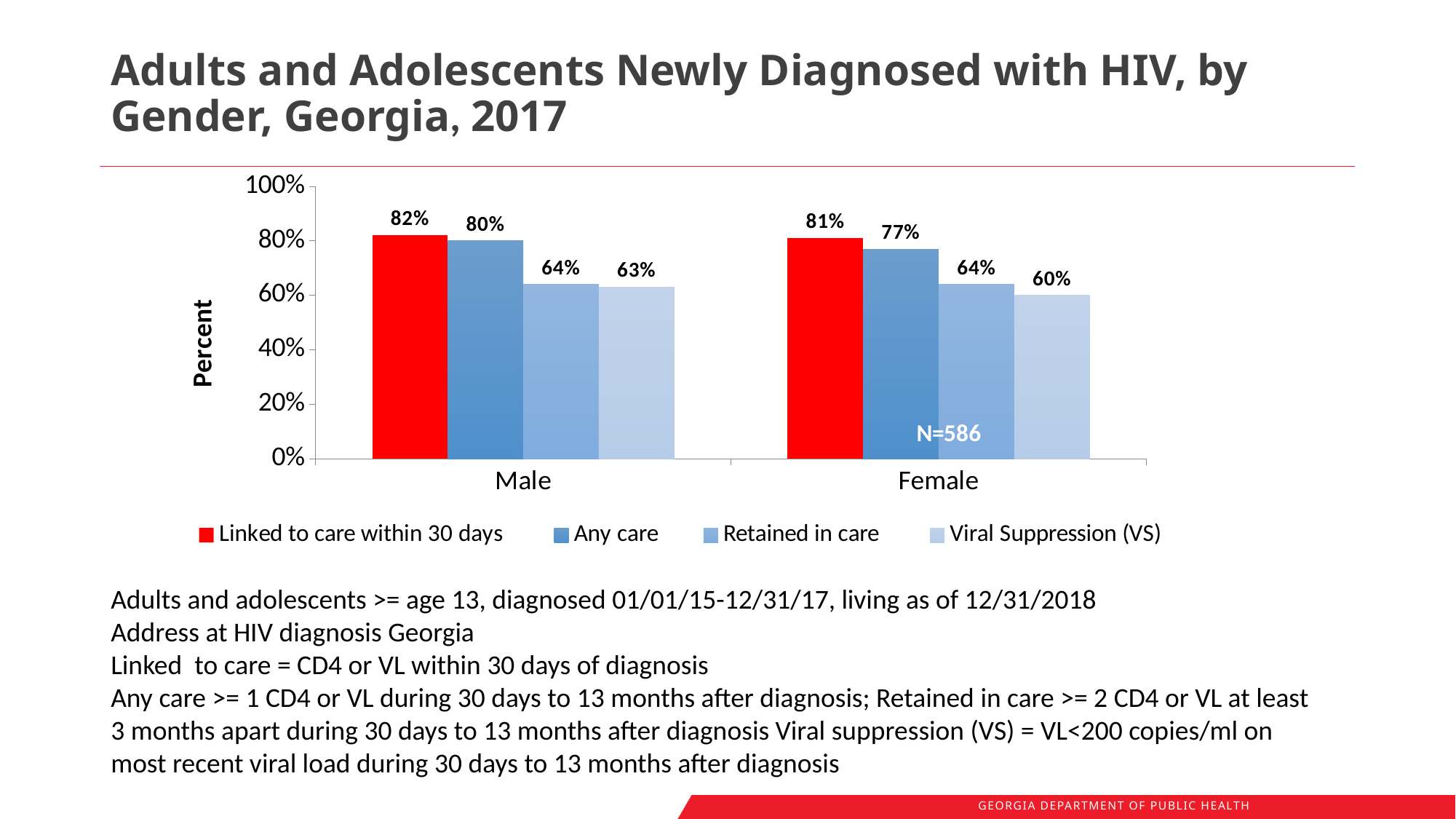
How many gender categories are shown on the x axis? 2 What is the difference between the Any care values for males and females? 3% What is the Any care value for females? 77% Is the Viral Suppression (VS) value higher for males or females? Males What is the Viral Suppression (VS) value for females? 60% What kind of chart is shown on the slide? Bar chart What percentage of males were linked to care within 30 days? 82% What is the Retained in care value for males? 64% Which series has the lowest value for females? Viral Suppression (VS) What is the N value printed on the chart? N=586 Which series has the highest value for males? Linked to care within 30 days How many series does the legend list? 4